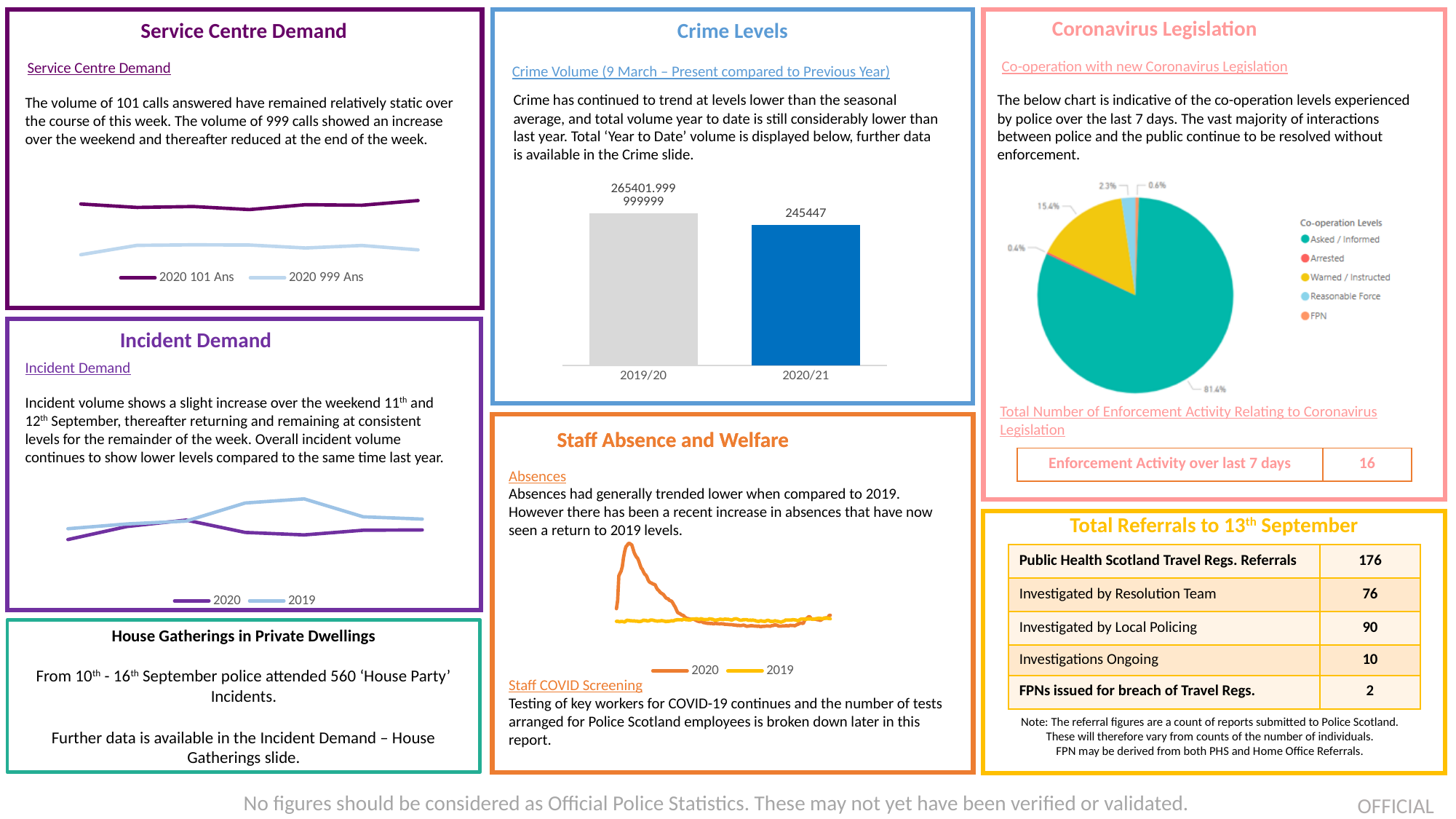
In the Coronavirus Legislation pie chart, what share is Reasonable Force? 2.3% In the Coronavirus Legislation pie chart, which co-operation level has the largest slice? Asked / Informed In the Crime Levels bar chart, which year has the higher crime volume, 2019/20 or 2020/21? 2019/20 What kind of chart is used in the Crime Levels panel? bar chart In the Crime Levels bar chart, what is the value for 2020/21? 245447 In the Coronavirus Legislation pie chart, what share is Asked / Informed? 81.4% In the Coronavirus Legislation pie chart, what share is Warned / Instructed? 15.4% How many co-operation levels does the legend of the Coronavirus Legislation pie chart list? 5 How many series does the legend of the Service Centre Demand line chart list? 2 How many categories are shown in the Crime Levels bar chart? 2 In the Coronavirus Legislation pie chart, what is the difference between the Asked / Informed share and the Warned / Instructed share? 66.0% In the Service Centre Demand line chart, which series is plotted higher, 2020 101 Ans or 2020 999 Ans? 2020 101 Ans